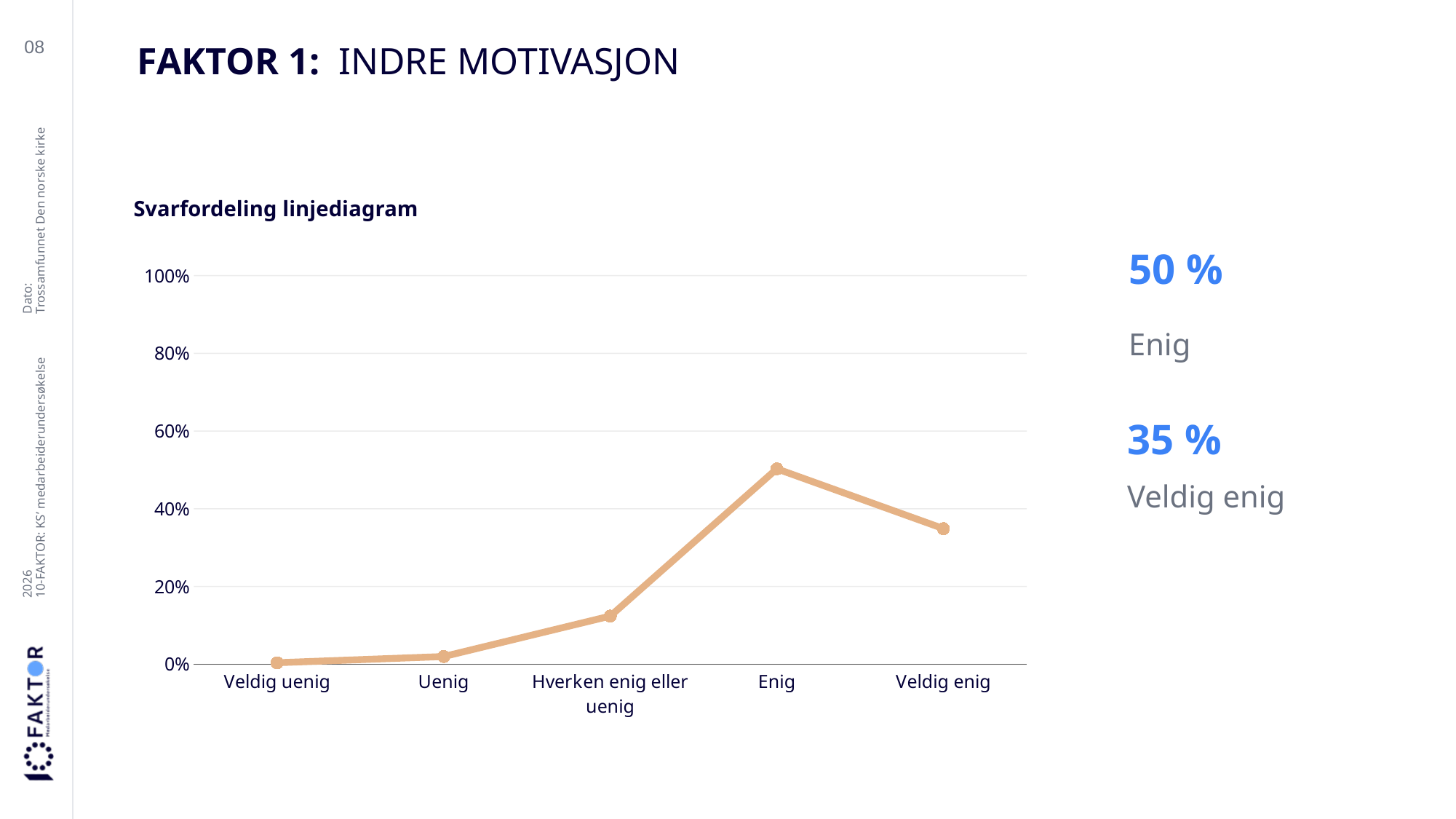
How many categories are shown on the x axis? 5 Is the value for Veldig uenig greater or less than 20%? less What is the value for Veldig enig? 35 % Is the value for Hverken enig eller uenig greater or less than 20%? less What is the value for Enig? 50 % What is the difference between the values for Enig and Veldig enig? 15 % What is the title of the chart? Svarfordeling linjediagram Which is larger, the value for Enig or the value for Veldig enig? Enig Do the values rise or fall from Veldig uenig to Enig? rise What kind of chart is shown on the slide? line chart Is the value for Uenig greater or less than 20%? less Which category has the highest value? Enig